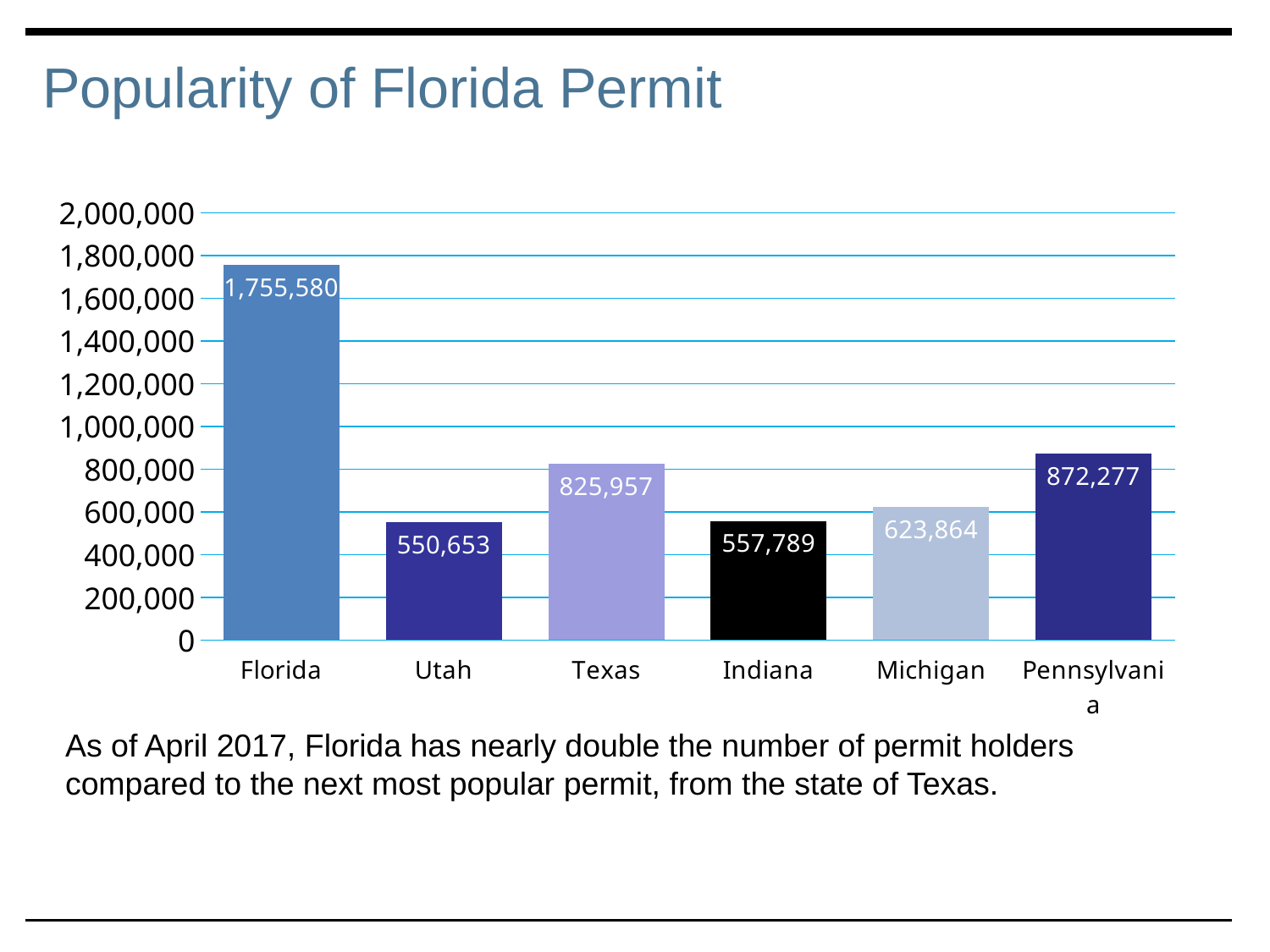
How many states are shown on the chart? 6 Which state has the highest value? Florida What is the value for Texas? 825,957 What is the value for Michigan? 623,864 What is the value for Pennsylvania? 872,277 What is the difference between the values for Pennsylvania and Michigan? 248,413 What is the value for Florida? 1,755,580 Is the value for Michigan greater or less than 800,000? less Which state has the lowest value? Utah What is the difference between the values for Florida and Texas? 929,623 What kind of chart is shown on the slide? bar chart Which is larger, the value for Pennsylvania or the value for Texas? Pennsylvania